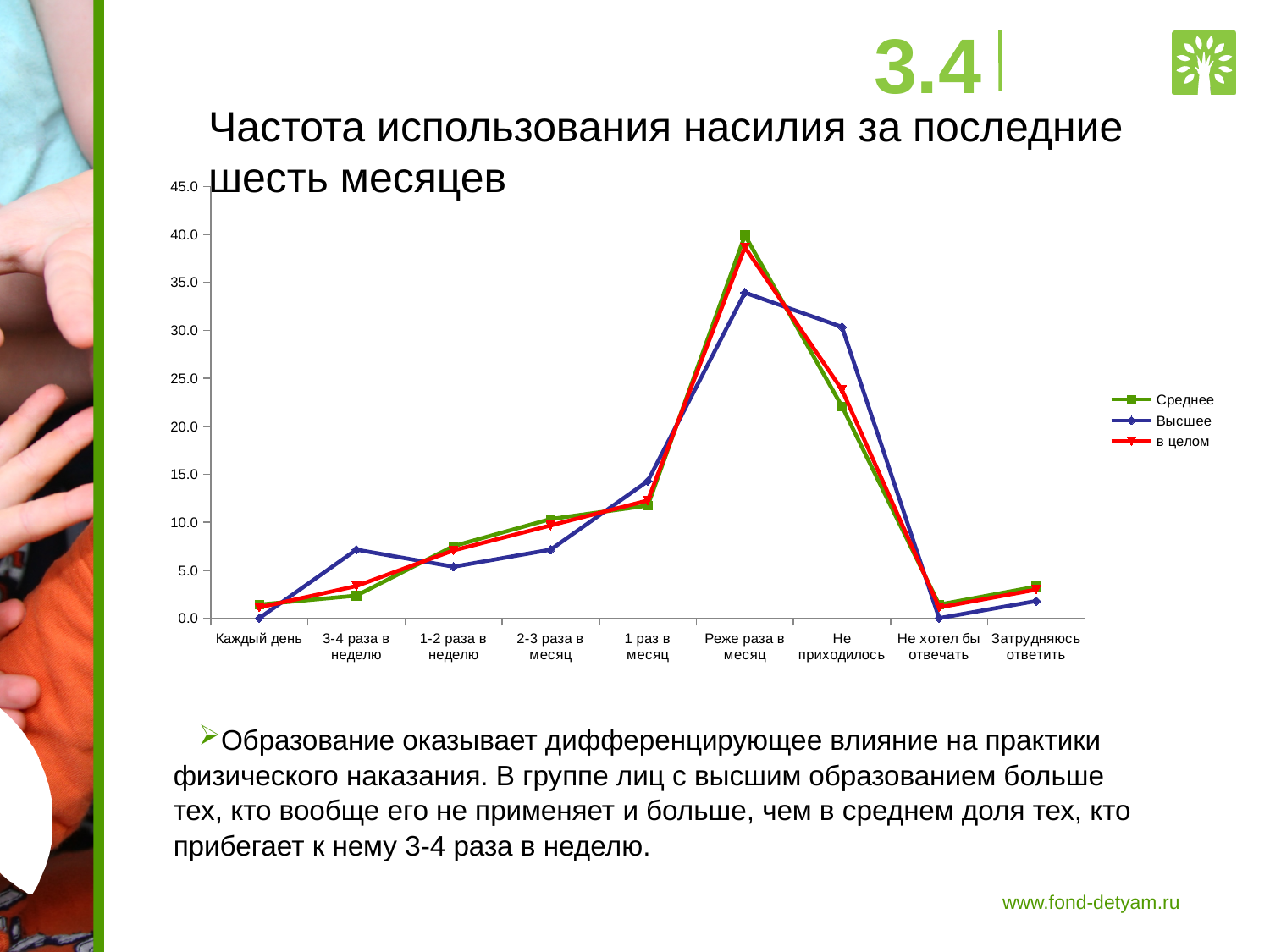
Is the value for Среднее at 'Реже раза в месяц' greater or less than 35.0? greater Do the values of the 'в целом' series rise or fall from 'Реже раза в месяц' to 'Не хотел бы отвечать'? fall At '3-4 раза в неделю', which series has the larger value, Высшее or Среднее? Высшее Which category has the highest value for the Среднее series? Реже раза в месяц How many series does the legend list? 3 At 'Не приходилось', which series has the larger value, Высшее or Среднее? Высшее Which category has the highest value for the Высшее series? Реже раза в месяц What kind of chart is shown on the slide? line chart What is the title of the chart? Частота использования насилия за последние шесть месяцев How many categories are shown along the x axis? 9 Is the value for Высшее at 'Не приходилось' greater or less than 25.0? greater Is the value for Среднее at 'Не приходилось' greater or less than 25.0? less